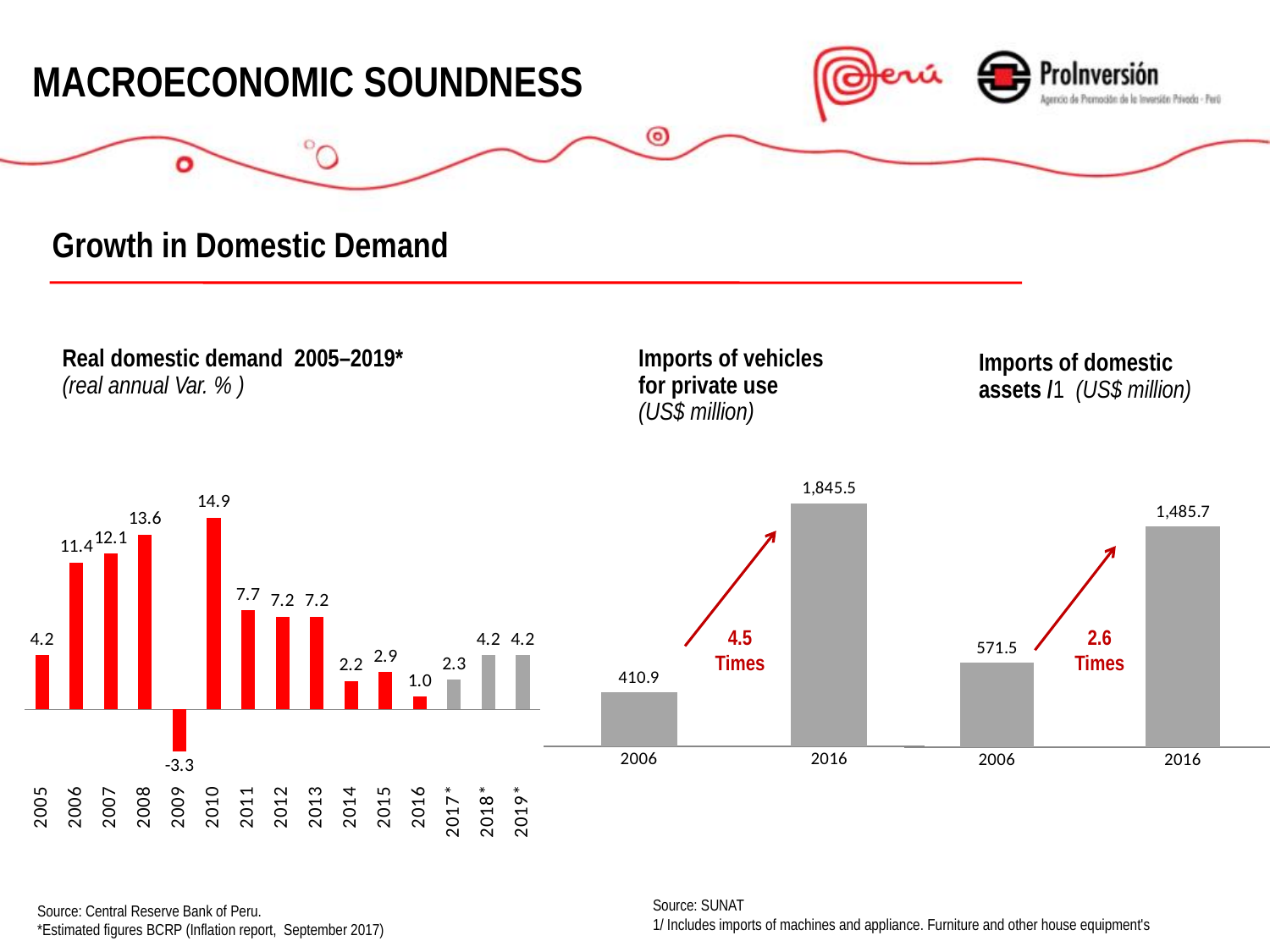
In the 'Real domestic demand 2005–2019' chart, which year has the lowest value? 2009 In the 'Real domestic demand 2005–2019' chart, which year has the highest value? 2010 In the 'Imports of domestic assets' chart, what is the difference between the 2016 and 2006 values? 914.2 In the 'Imports of vehicles for private use' chart, what is the value for 2016? 1,845.5 In the 'Imports of vehicles for private use' chart, what is the value for 2006? 410.9 In the 'Real domestic demand 2005–2019' chart, which is larger, the value for 2014 or the value for 2015? 2015 What type of chart is the 'Imports of domestic assets' chart? Bar chart In the 'Real domestic demand 2005–2019' chart, what is the value for 2009? -3.3 In the 'Real domestic demand 2005–2019' chart, what is the difference between the values for 2008 and 2007? 1.5 In the 'Real domestic demand 2005–2019' chart, how many years are plotted? 15 In the 'Imports of domestic assets' chart, what is the value for 2006? 571.5 In the 'Real domestic demand 2005–2019' chart, what is the value for 2010? 14.9